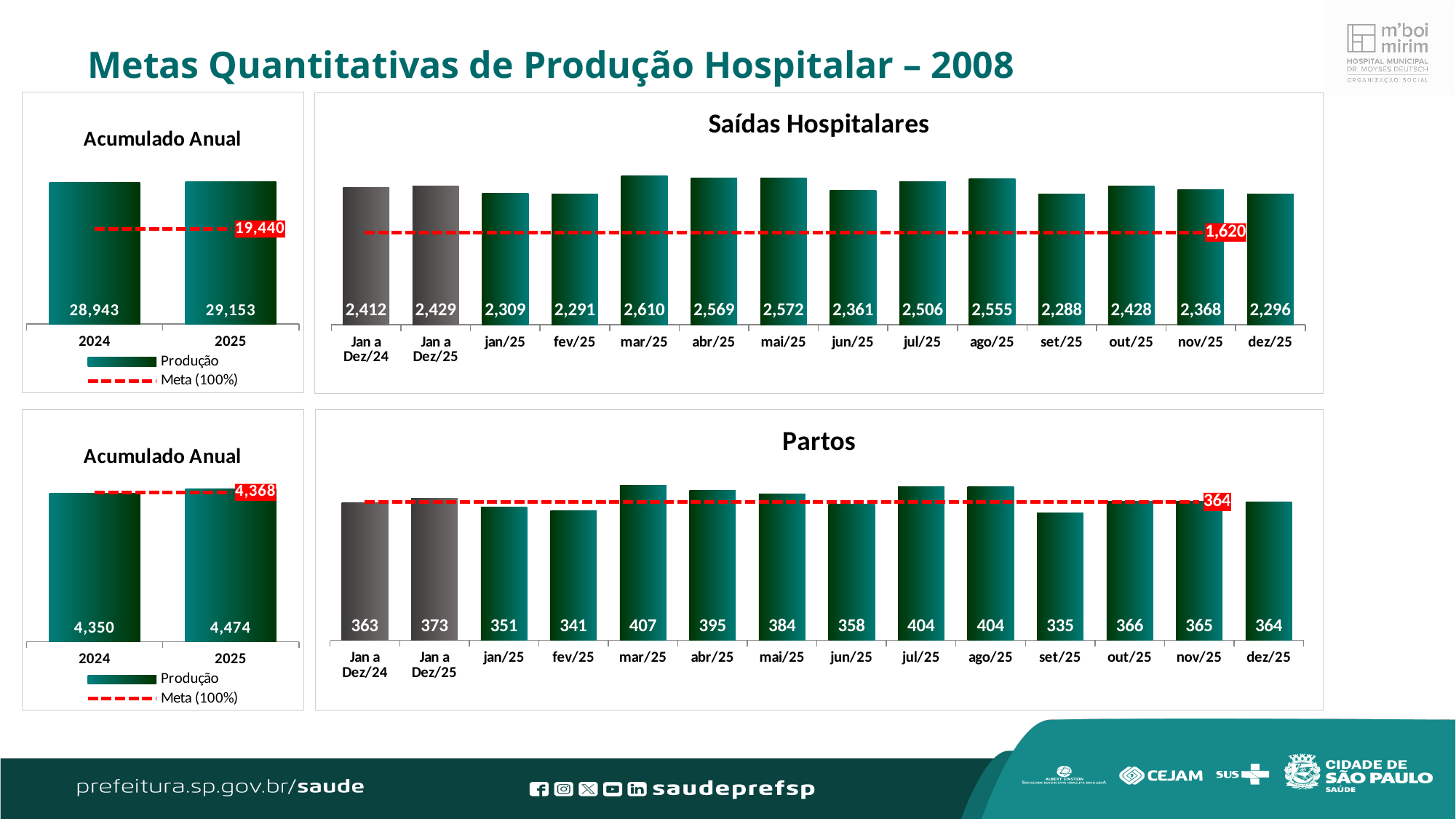
In the bottom-left Acumulado Anual chart, what is the difference between the 2025 and 2024 values? 124 In the Partos chart, what is the value for set/25? 335 In the Saídas Hospitalares chart, what is the value for mar/25? 2,610 What type of chart is the Saídas Hospitalares chart? Bar chart In the Saídas Hospitalares chart, which month of 2025 has the lowest value? set/25 In the Partos chart, which is larger, the value for abr/25 or the value for jun/25? abr/25 In the Saídas Hospitalares chart, what is the difference between the Jan a Dez/25 and Jan a Dez/24 values? 17 In the Partos chart, which month of 2025 has the highest value? mar/25 In the top-left Acumulado Anual chart, what is the value for 2025? 29,153 In the Partos chart, how many bars are plotted? 14 In the Saídas Hospitalares chart, what is the value of the Meta (100%) line? 1,620 In the bottom-left Acumulado Anual chart, what is the value of the Meta (100%) line? 4,368